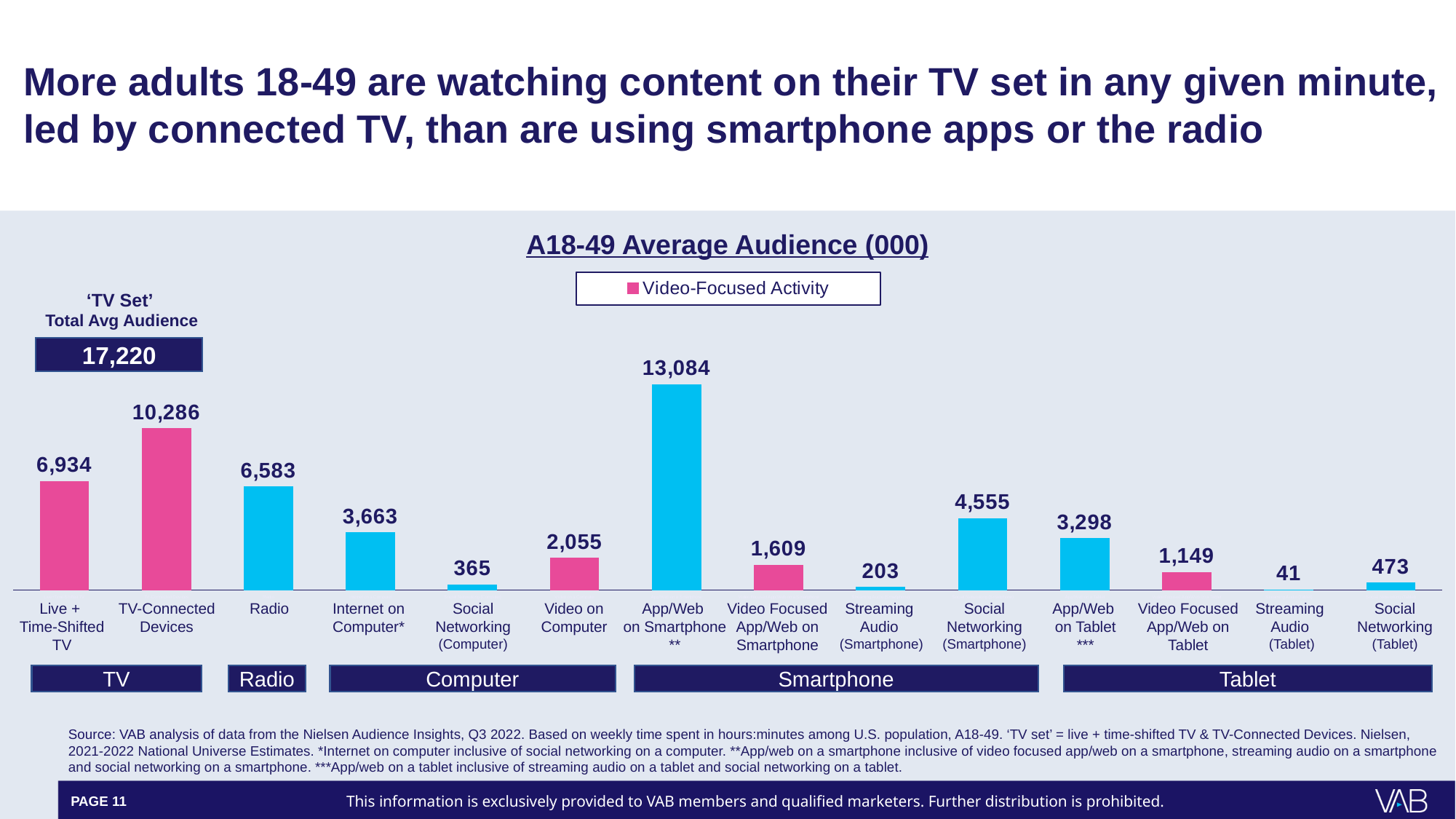
What is the title of the chart? A18-49 Average Audience (000) Which category has the highest average audience in the chart? App/Web on Smartphone What does the legend entry in the chart say? Video-Focused Activity What is the 'TV Set' Total Avg Audience shown on the slide? 17,220 What is the A18-49 average audience (000) for TV-Connected Devices? 10,286 What is the difference between the values for TV-Connected Devices and Live + Time-Shifted TV? 3,352 How many categories (bars) are plotted in the chart? 14 What kind of chart is shown on the slide? Bar chart What is the value shown for Streaming Audio (Tablet)? 41 Which category has the lowest average audience in the chart? Streaming Audio (Tablet) What is the A18-49 average audience (000) for App/Web on Smartphone? 13,084 Which is larger, the value for Radio or the value for Social Networking (Smartphone)? Radio